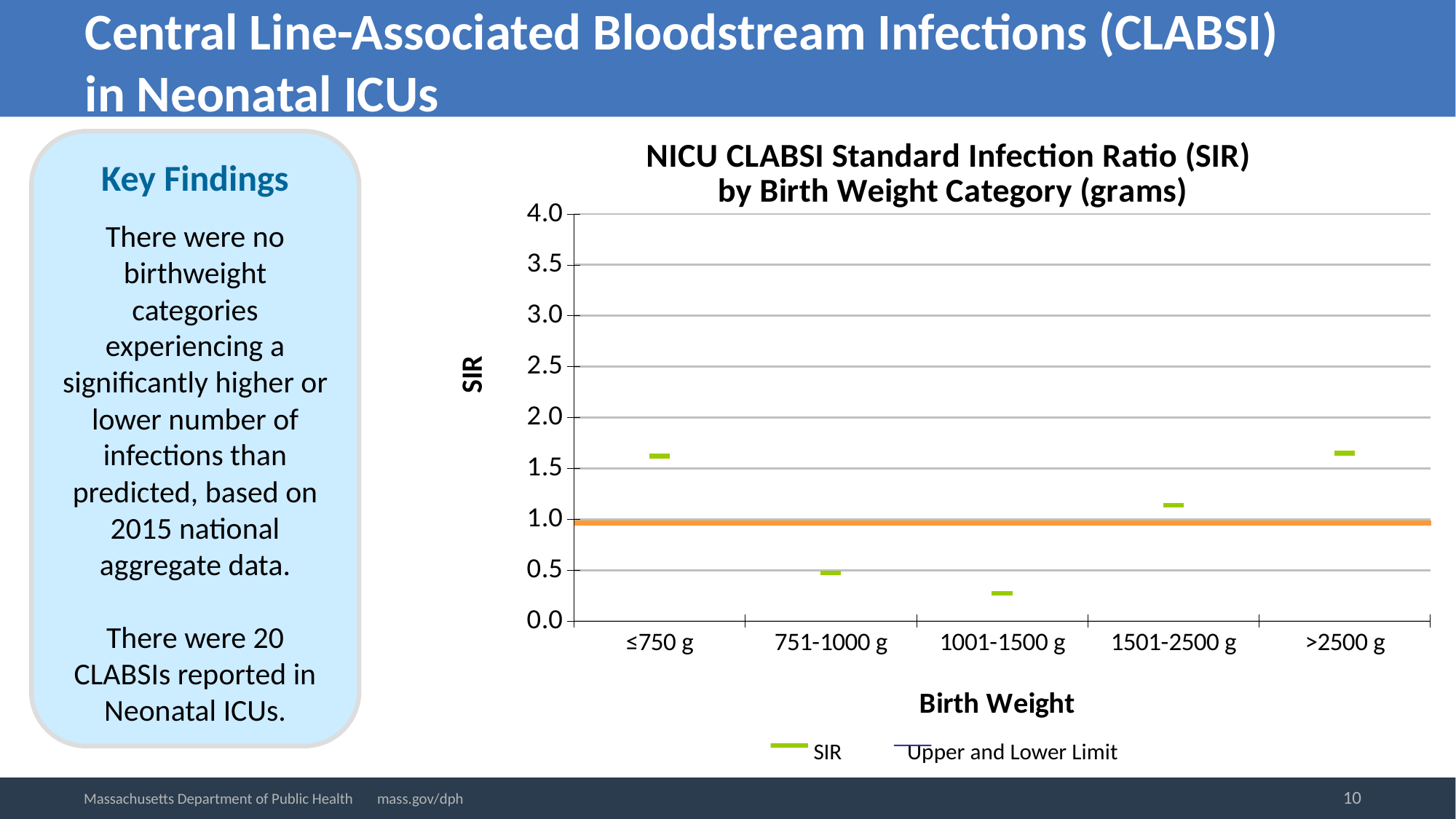
Is the SIR value for >2500 g greater or less than 1.5? greater How many series does the legend of the NICU CLABSI SIR chart list? 2 Which birth weight category has the lowest SIR in the NICU CLABSI chart? 1001-1500 g What is the label of the y axis on the NICU CLABSI chart? SIR Which has the larger SIR, ≤750 g or 751-1000 g? ≤750 g Is the SIR value for 1001-1500 g greater or less than 0.5? less Which has the larger SIR, 1501-2500 g or 1001-1500 g? 1501-2500 g How many birth weight categories are shown on the x axis of the NICU CLABSI SIR chart? 5 What are the two entries listed in the legend of the NICU CLABSI chart? SIR; Upper and Lower Limit Is the SIR value for ≤750 g greater or less than 1.5? greater